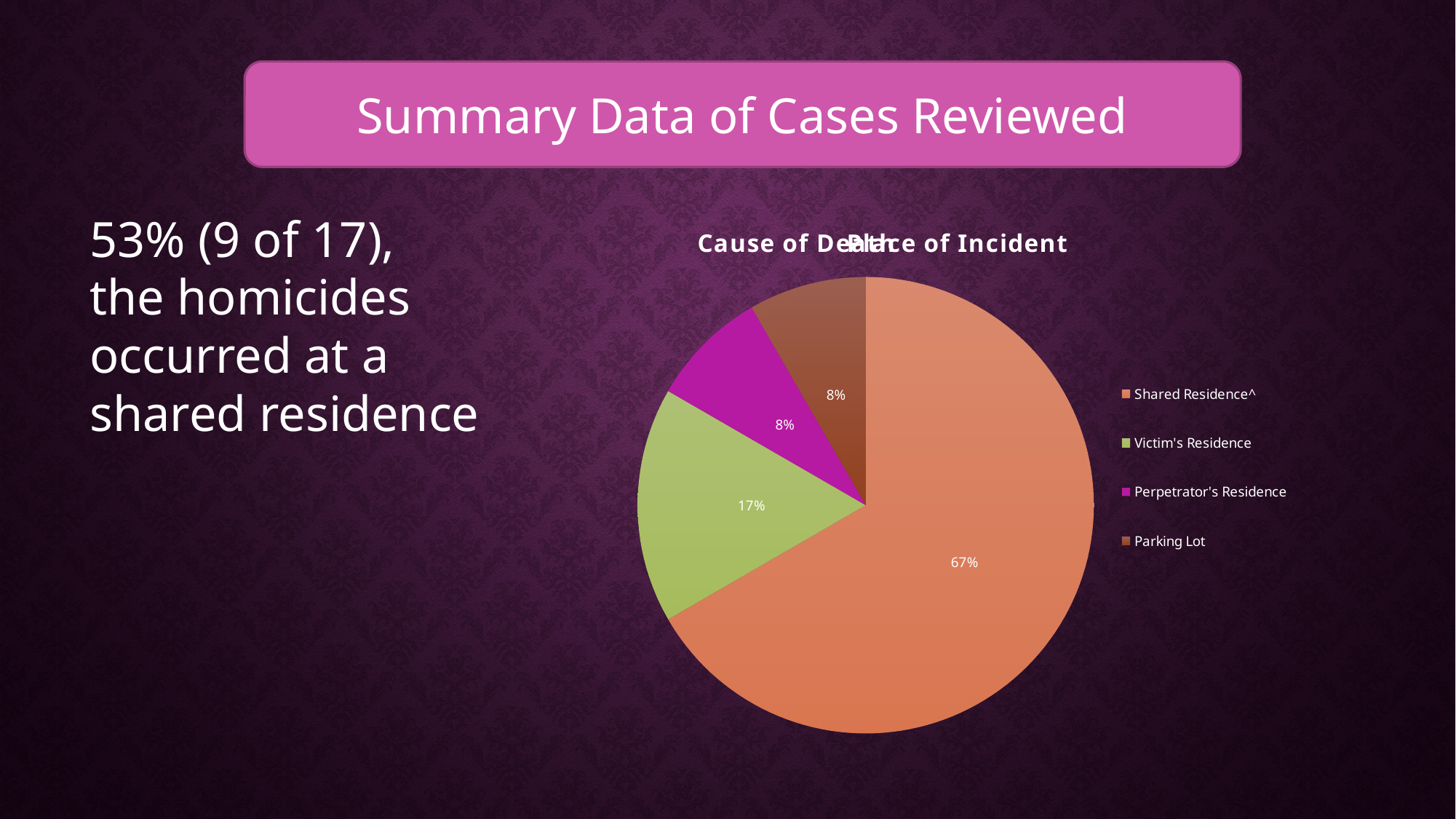
How many categories are shown in the pie chart? 4 What is the difference in percentage points between Shared Residence^ and Victim's Residence? 50 What colour is the Shared Residence^ slice in the pie chart? Orange What percentage is shown for Parking Lot in the pie chart? 8% What percentage is shown for Victim's Residence in the pie chart? 17% What is the difference in percentage points between Victim's Residence and Perpetrator's Residence? 9 Which legend entry in the pie chart is shown in green? Victim's Residence What percentage is shown for Perpetrator's Residence in the pie chart? 8% Which is larger in the pie chart, Victim's Residence or Parking Lot? Victim's Residence What kind of chart is shown on the slide? Pie chart Which category has the largest slice in the pie chart? Shared Residence^ What share of the pie chart does Shared Residence^ account for? 67%